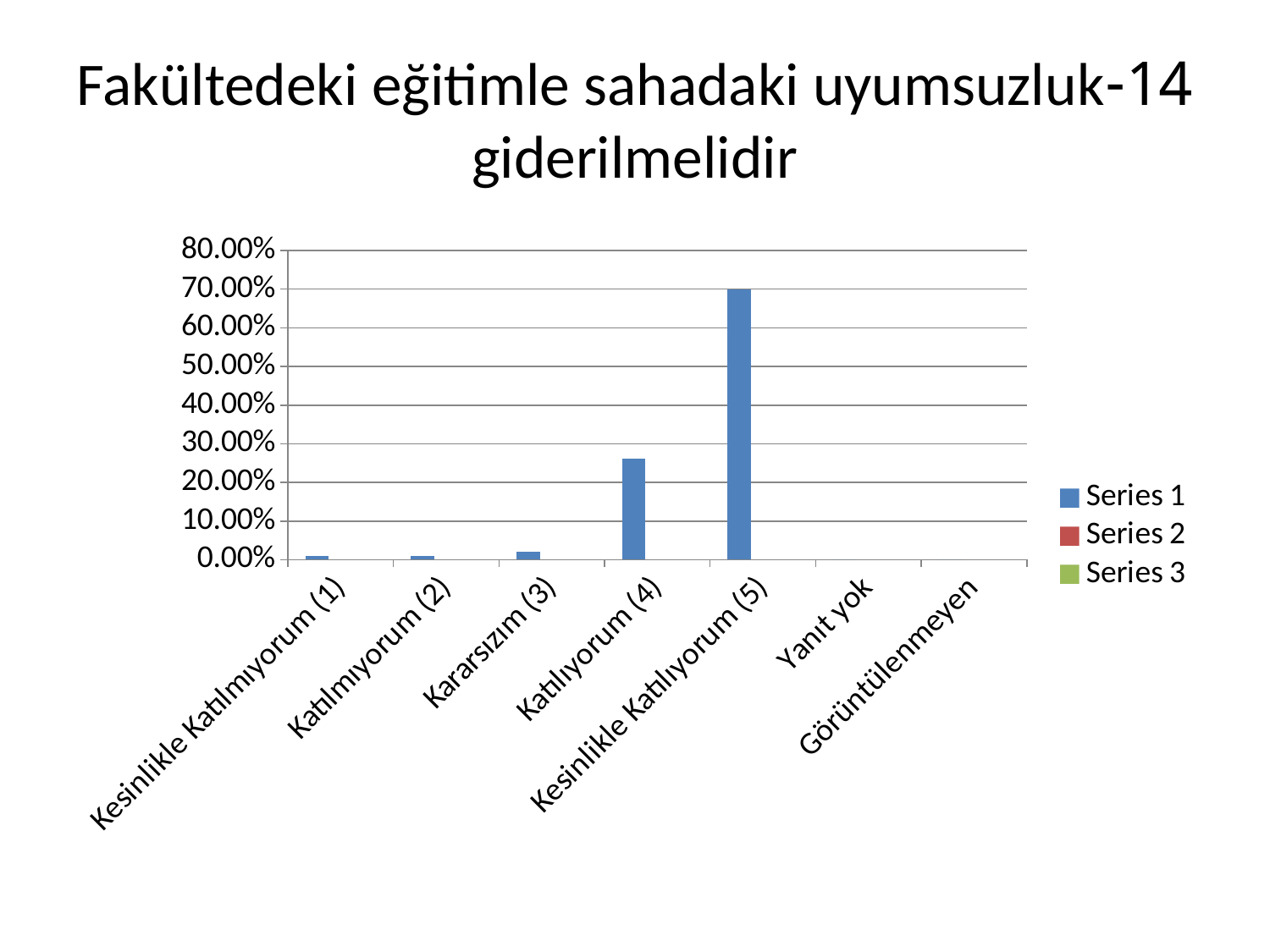
What is the title of the slide containing the chart? Fakültedeki eğitimle sahadaki uyumsuzluk-14 giderilmelidir Is the value for Katılıyorum (4) greater or less than 30%? less Is the value for Kesinlikle Katılıyorum (5) greater or less than 80%? less How many categories are shown on the x axis of the chart? 7 Is the value for Katılıyorum (4) greater or less than 20%? greater Which is larger, the value for Kararsızım (3) or the value for Katılıyorum (4)? Katılıyorum (4) Which is larger, the value for Katılıyorum (4) or the value for Kesinlikle Katılıyorum (5)? Kesinlikle Katılıyorum (5) What kind of chart is shown on the slide? bar chart How many series does the chart's legend list? 3 Which category has the highest value in the chart? Kesinlikle Katılıyorum (5)